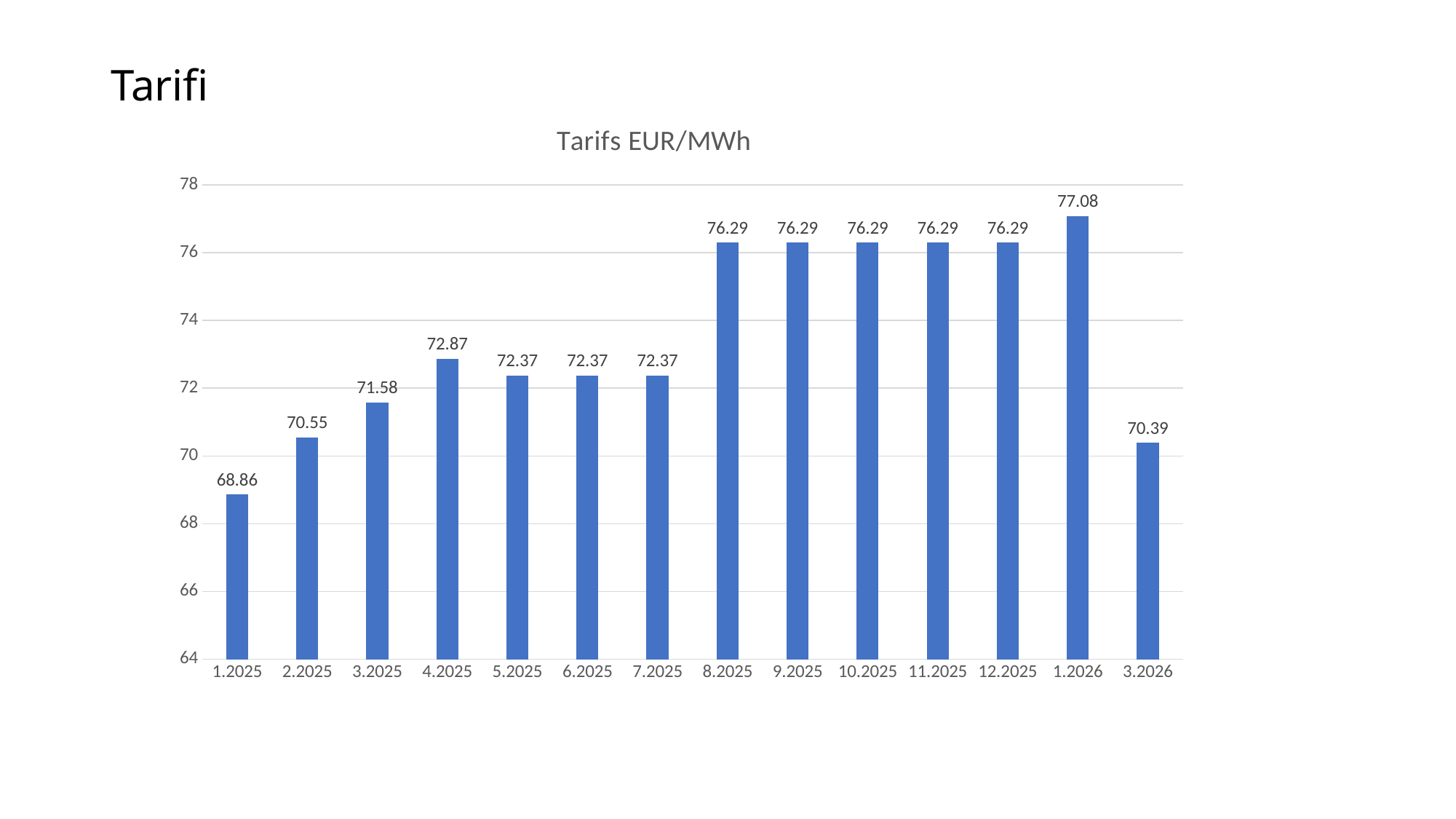
What is the difference between the values for 4.2025 and 1.2025? 4.01 Which is larger, the value for 3.2025 or the value for 3.2026? 3.2025 What kind of chart is this? bar chart What is the value for 3.2026? 70.39 What is the title of the chart? Tarifs EUR/MWh Is the value for 8.2025 greater or less than 76? greater What is the difference between the values for 1.2026 and 12.2025? 0.79 What is the value for 1.2025? 68.86 How many categories are shown on the x axis? 14 Which category has the lowest value? 1.2025 Which category has the highest value? 1.2026 What is the value for 4.2025? 72.87